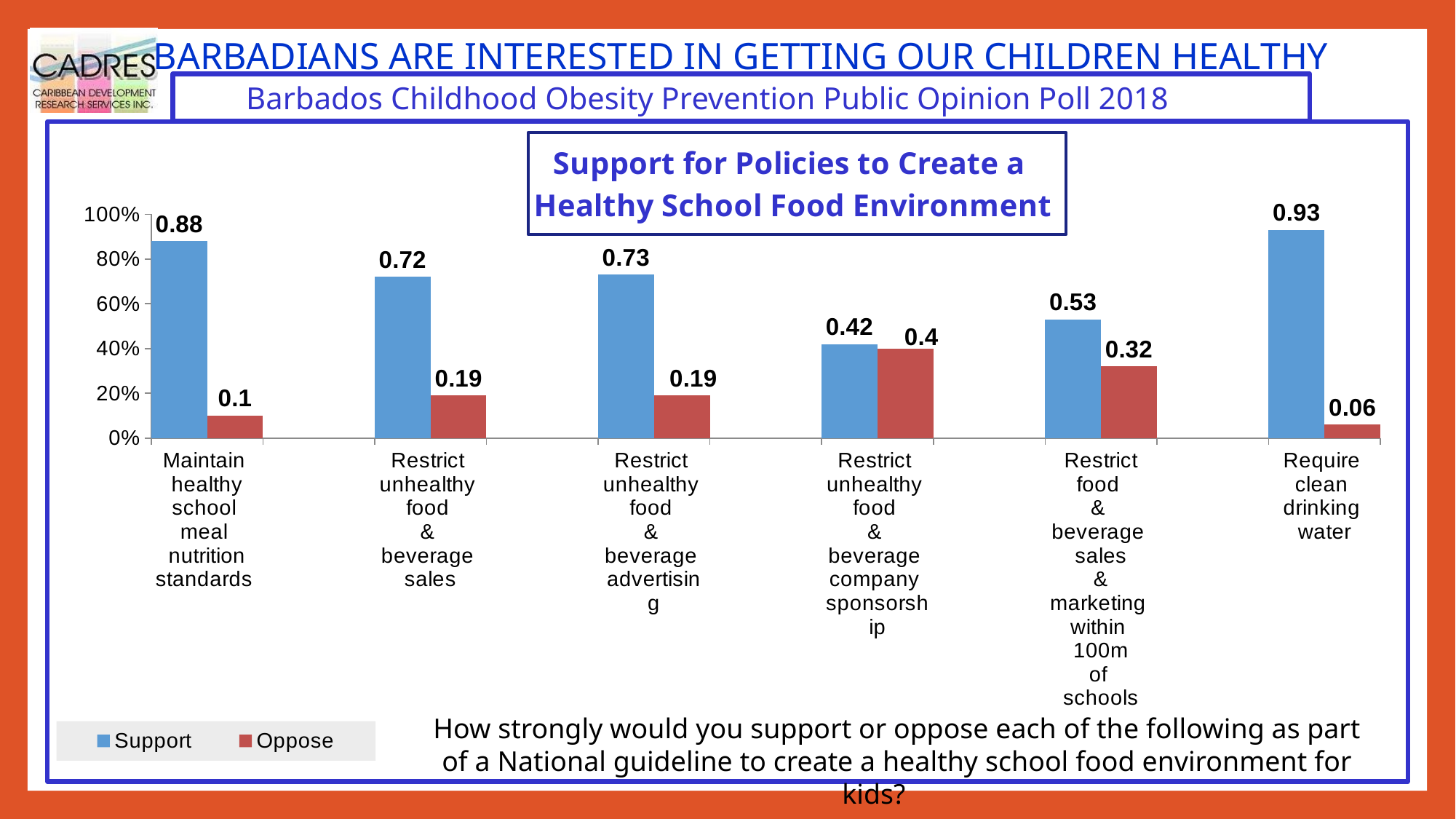
How many series does the legend list? 2 What is the title of the chart? Support for Policies to Create a Healthy School Food Environment Which policy has the lowest Oppose value? Require clean drinking water Which is larger: the Support value for 'Restrict unhealthy food & beverage sales' or the Support value for 'Restrict unhealthy food & beverage company sponsorship'? Restrict unhealthy food & beverage sales What kind of chart is shown on the slide? Bar chart What is the Oppose value for 'Restrict unhealthy food & beverage company sponsorship'? 0.4 What is the Support value for 'Require clean drinking water'? 0.93 Which policy has the highest Support value? Require clean drinking water How many policies are shown on the x axis of the chart? 6 Which colour represents the Oppose series in the chart? Red What is the Support value for 'Restrict food & beverage sales & marketing within 100m of schools'? 0.53 What is the difference between the Support and Oppose values for 'Maintain healthy school meal nutrition standards'? 0.78